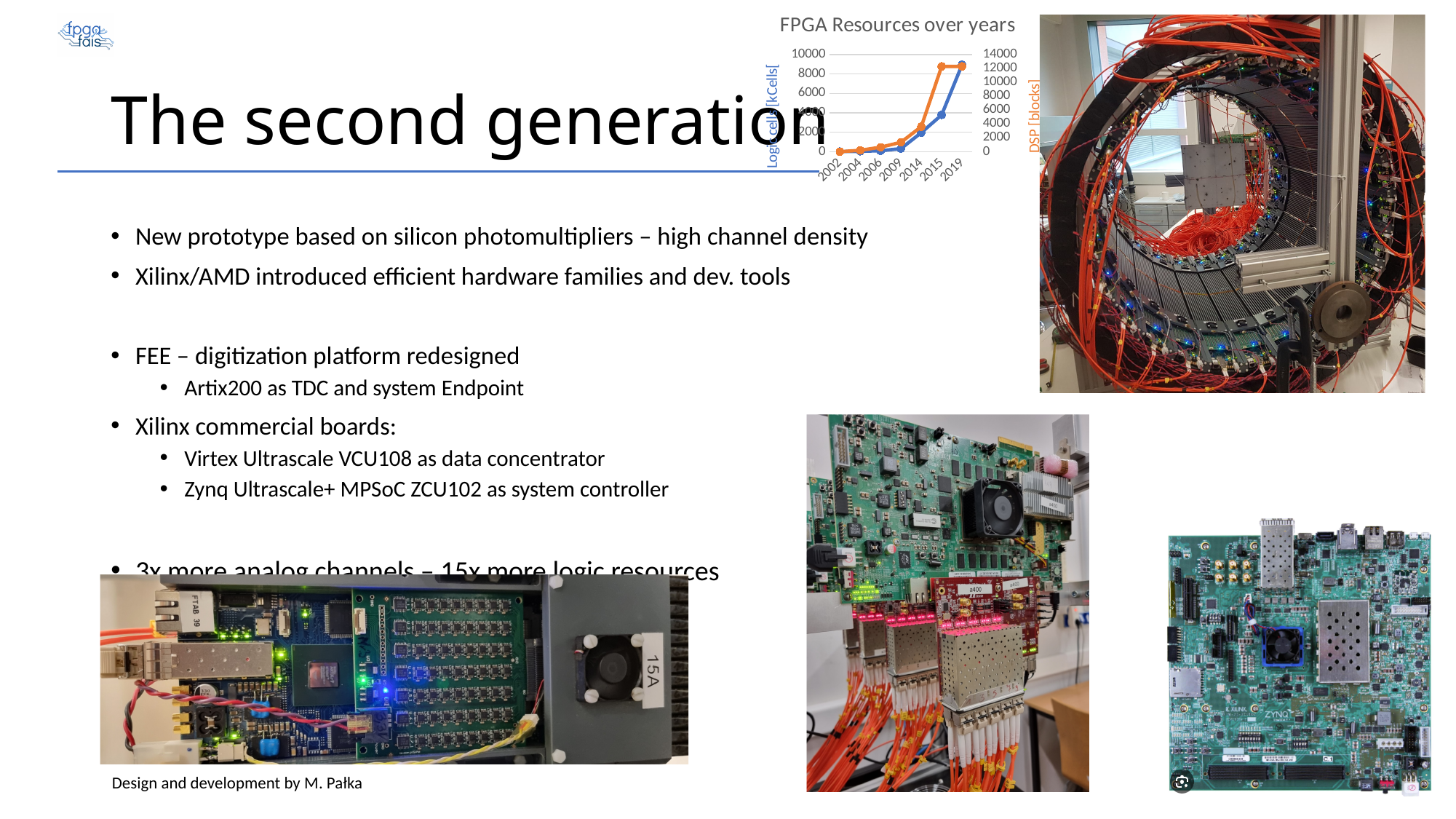
In the 'FPGA Resources over years' chart, do the values of the blue Logic cells line rise or fall from 2002 to 2019? rise In the 'FPGA Resources over years' chart, is the orange DSP value for 2009 greater or less than 4000 on the right axis? less In the 'FPGA Resources over years' chart, is the orange DSP value for 2015 greater or less than 10000 on the right axis? greater In the 'FPGA Resources over years' chart, which year has the larger blue Logic cells value, 2015 or 2019? 2019 In the 'FPGA Resources over years' chart, which year has the larger orange DSP value, 2014 or 2015? 2015 In the 'FPGA Resources over years' chart, is the blue Logic cells value for 2002 greater or less than 2000 on the left axis? less How many years are shown on the x axis of the 'FPGA Resources over years' chart? 7 What kind of chart is the 'FPGA Resources over years' chart? line chart In the 'FPGA Resources over years' chart, what is the label of the left vertical axis? Logic cells [kCells] What is the title of the chart in the top-right area of the slide? FPGA Resources over years In the 'FPGA Resources over years' chart, which year has the highest value on the blue Logic cells line? 2019